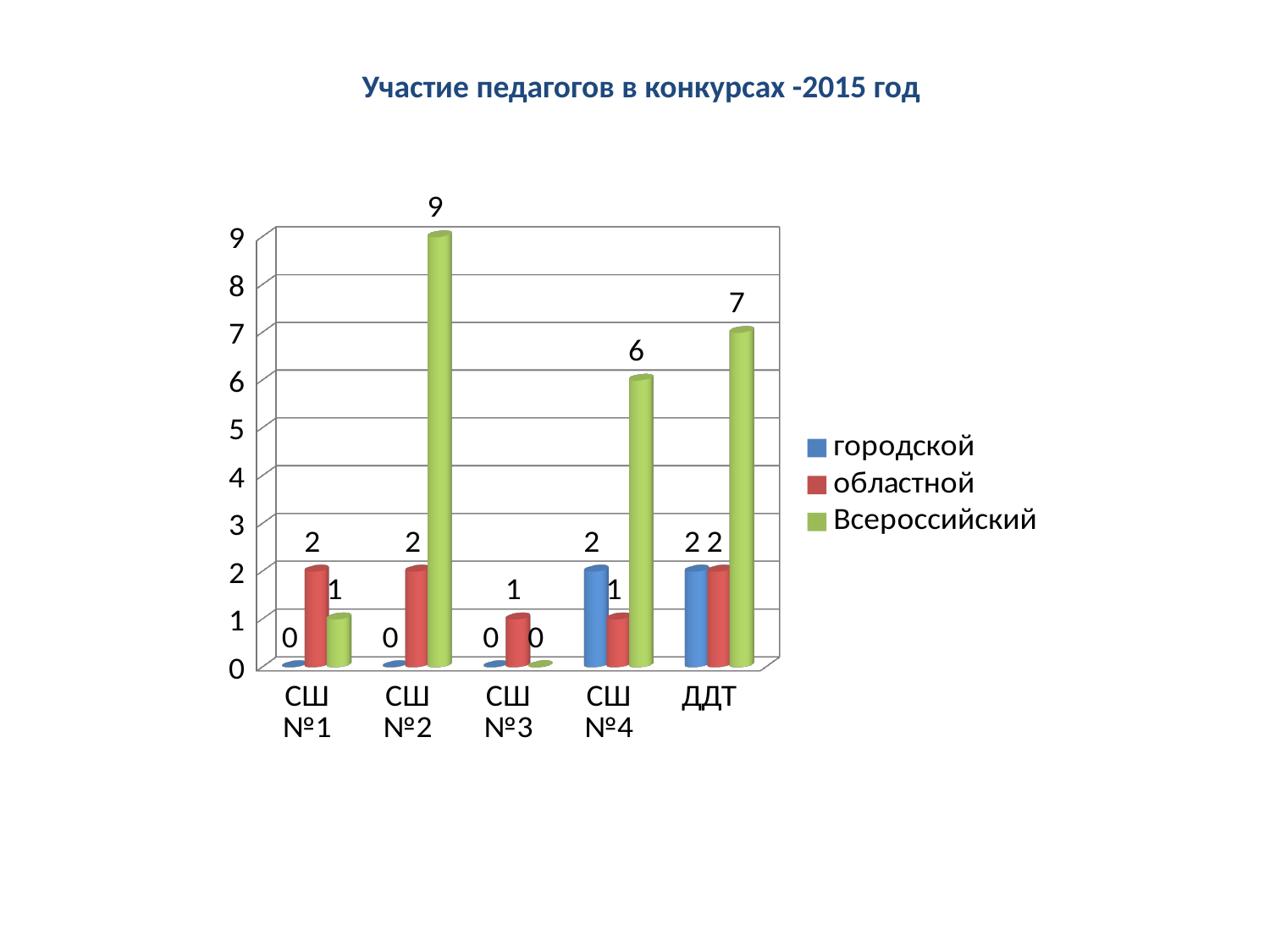
What is the value for Всероссийский at СШ №2? 9 How many series does the legend list? 3 Which is larger: the Всероссийский value for СШ №4 or for ДДТ? ДДТ What is the value for городской at ДДТ? 2 What is the difference between the Всероссийский values for СШ №2 and ДДТ? 2 What is the title of the chart? Участие педагогов в конкурсах -2015 год How many categories are shown on the x axis? 5 Which category has the lowest value for Всероссийский? СШ №3 What is the value for областной at СШ №4? 1 Which colour represents the областной series? red What kind of chart is shown on the slide? bar chart Which category has the highest value for Всероссийский? СШ №2